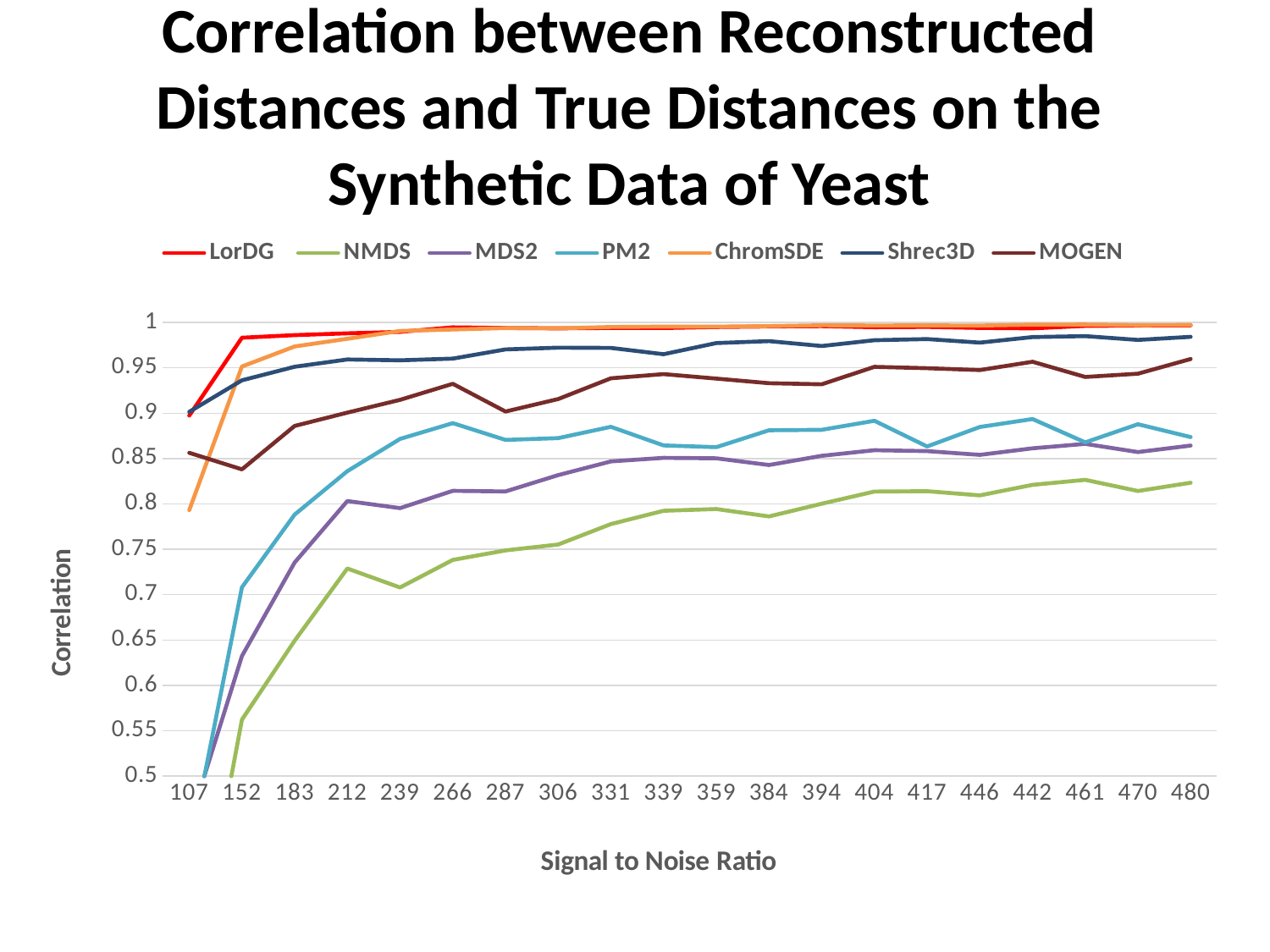
Which series has the lowest correlation at a signal-to-noise ratio of 152? NMDS Is the correlation for NMDS at a signal-to-noise ratio of 212 greater or less than 0.7? greater What is the label of the y axis? Correlation Is the correlation for NMDS at a signal-to-noise ratio of 480 greater or less than 0.8? greater What kind of chart is shown on the slide? line chart Is the correlation for ChromSDE at a signal-to-noise ratio of 107 greater or less than 0.8? less At a signal-to-noise ratio of 480, which series has the higher correlation, PM2 or NMDS? PM2 How many series does the legend list? 7 Does the correlation for NMDS generally rise or fall as the signal-to-noise ratio increases? rise How many signal-to-noise ratio values are shown on the x axis? 20 Which series has the highest correlation at a signal-to-noise ratio of 152? LorDG